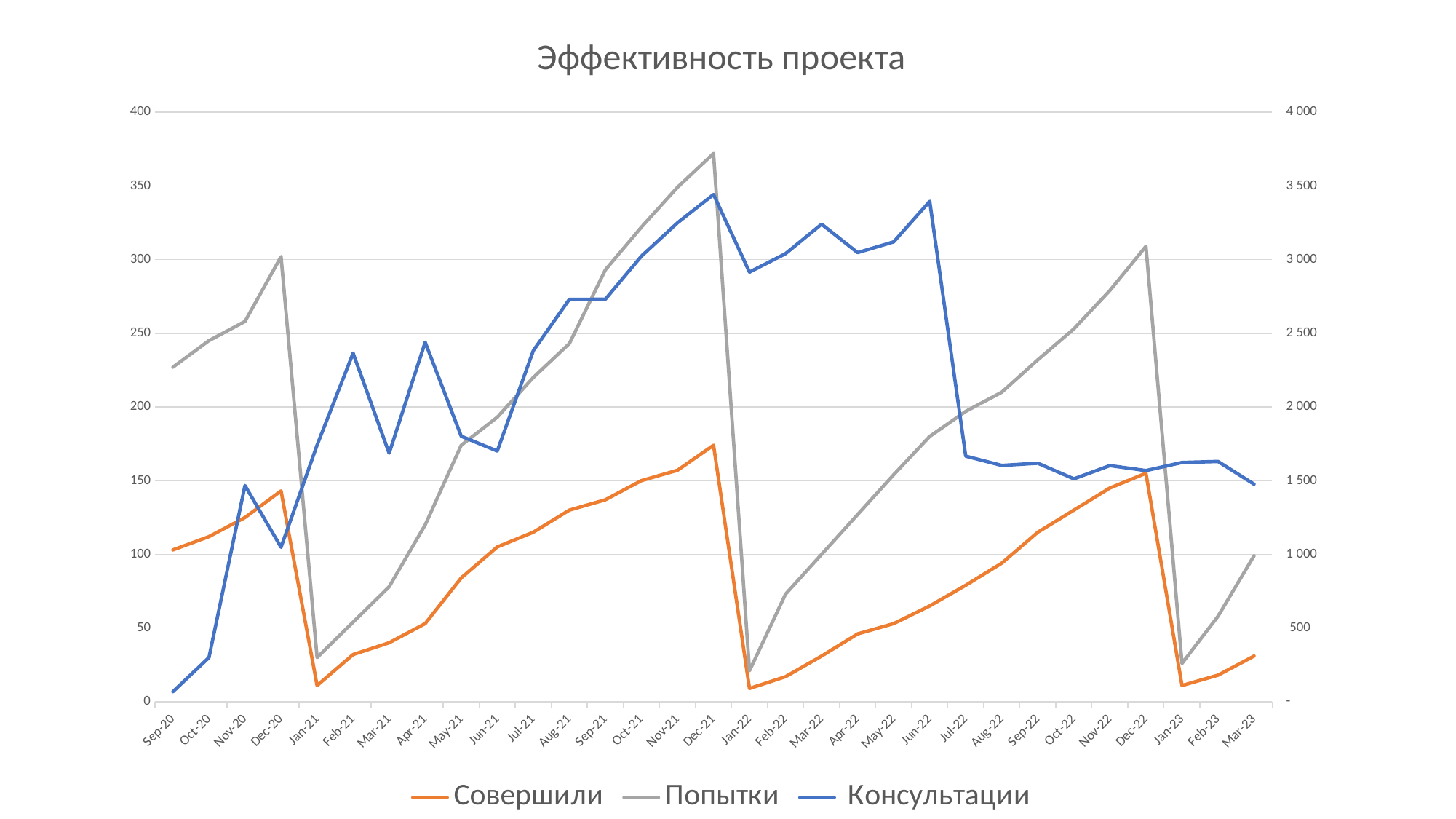
How many series does the legend list? 3 How many months are shown along the x axis? 31 What is the title of the chart? Эффективность проекта Does the Консультации series rise or fall from Jun-22 to Jul-22? fall For the Консультации series, is the value higher in Feb-21 or in Mar-21? Feb-21 In which month does the Попытки series reach its highest value? Dec-21 For the Совершили series, is the value higher in Dec-21 or in Dec-22? Dec-21 Which series is drawn in orange? Совершили In which month is the Консультации series at its lowest? Sep-20 In which month does the Совершили series reach its highest value? Dec-21 Does the Совершили series rise or fall from Jan-22 to Dec-22? rise What kind of chart is shown on the slide? line chart